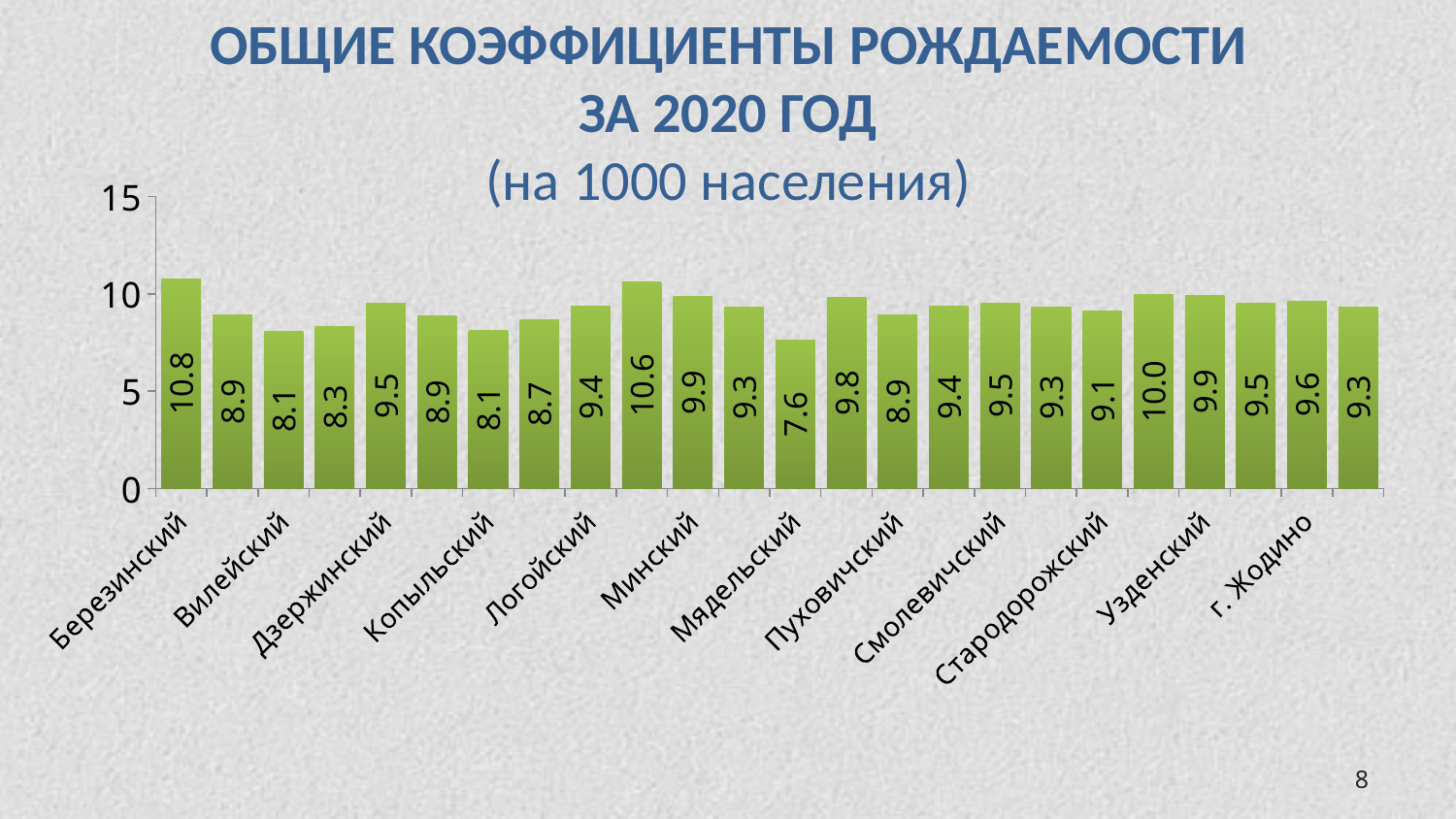
Is the value for Вилейский greater or less than 10? less What kind of chart is shown on the slide? Bar chart Which labelled district has the lowest birth rate on the chart? Мядельский What is the birth rate value for Мядельский? 7.6 What is the birth rate value for Березинский? 10.8 How many bars are plotted on the chart? 24 What is the difference between the values for Березинский and Мядельский? 3.2 What is the birth rate value for Узденский? 9.9 Which labelled district has the highest birth rate on the chart? Березинский What year does the chart title say the birth rates are for? 2020 What is the birth rate value for г. Жодино? 9.6 Which has the larger value, Минский or Логойский? Минский